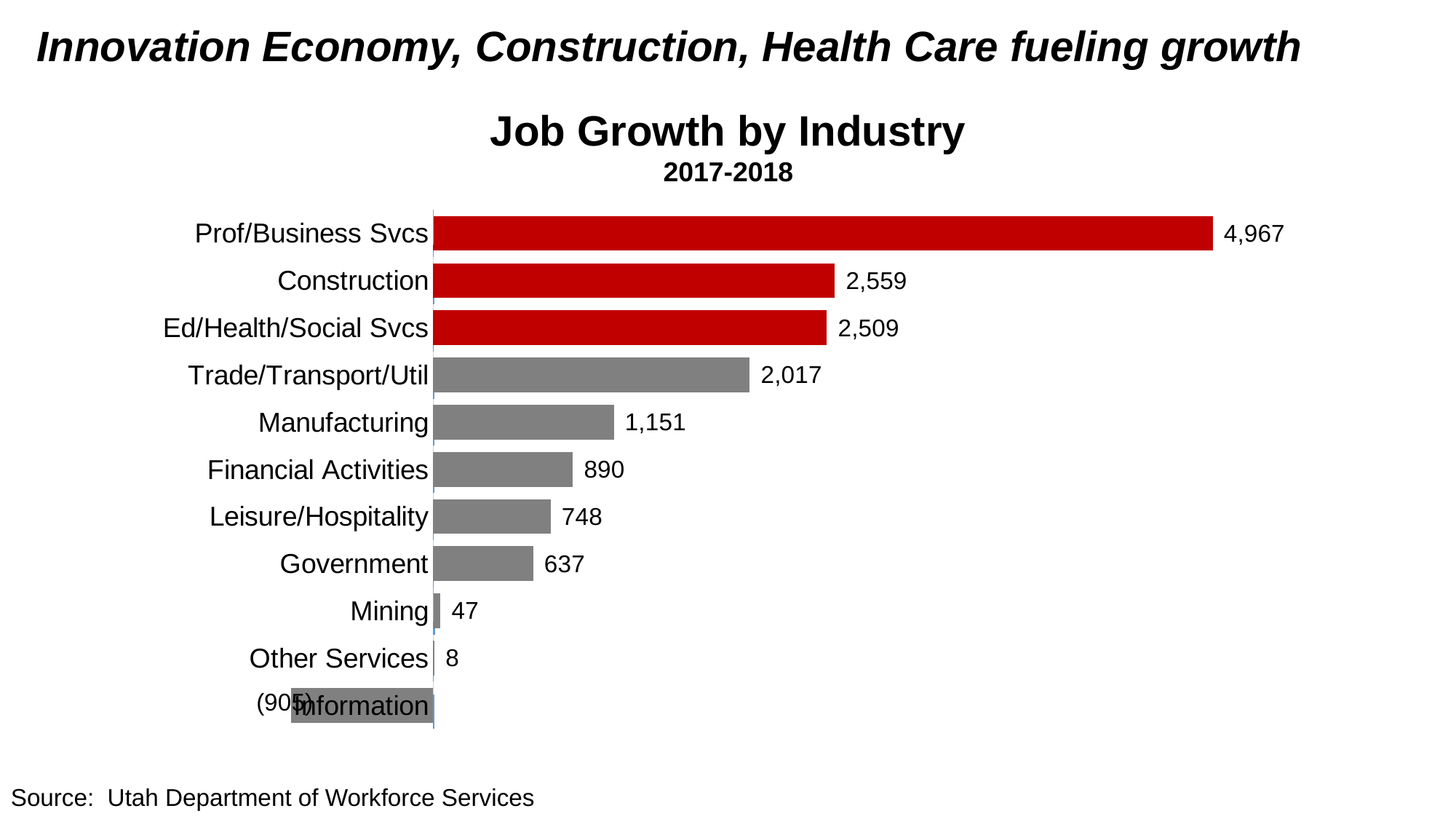
What is the job growth value for Prof/Business Svcs? 4,967 What type of chart is shown on the slide? Bar chart What is the job growth value for Manufacturing? 1,151 Which industry has the lowest job growth? Information What is the difference between the job growth for Trade/Transport/Util and Manufacturing? 866 What is the difference between the job growth for Prof/Business Svcs and Construction? 2,408 How many industries are shown in the chart? 11 What is the job growth value for Mining? 47 What is the job growth value for Construction? 2,559 Which industry has the highest job growth? Prof/Business Svcs What is the source cited for the chart data? Utah Department of Workforce Services Which has a larger job growth value, Financial Activities or Government? Financial Activities